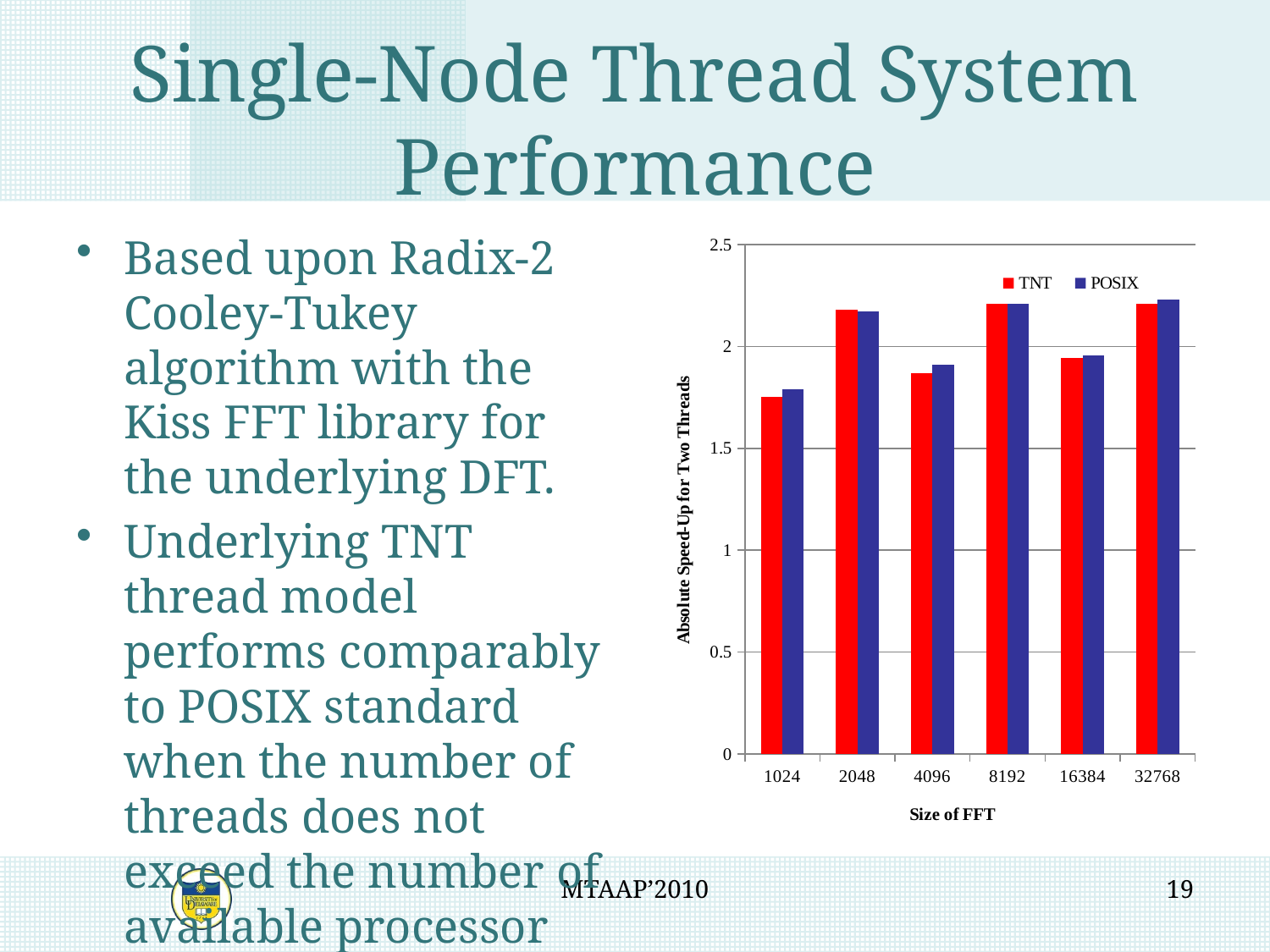
Is the POSIX value for FFT size 4096 greater or less than 2? less Is the POSIX value for FFT size 8192 greater or less than 2? greater Is the TNT value for FFT size 2048 greater or less than 2? greater Which is larger: the TNT value for FFT size 2048 or the TNT value for FFT size 1024? 2048 How many series does the chart's legend list? 2 What is the title of the chart's vertical axis? Absolute Speed-Up for Two Threads How many FFT sizes are shown along the x axis of the chart? 6 Which colour represents the POSIX series in the chart? blue What kind of chart is shown on the slide? bar chart For which FFT size is the TNT speed-up lowest? 1024